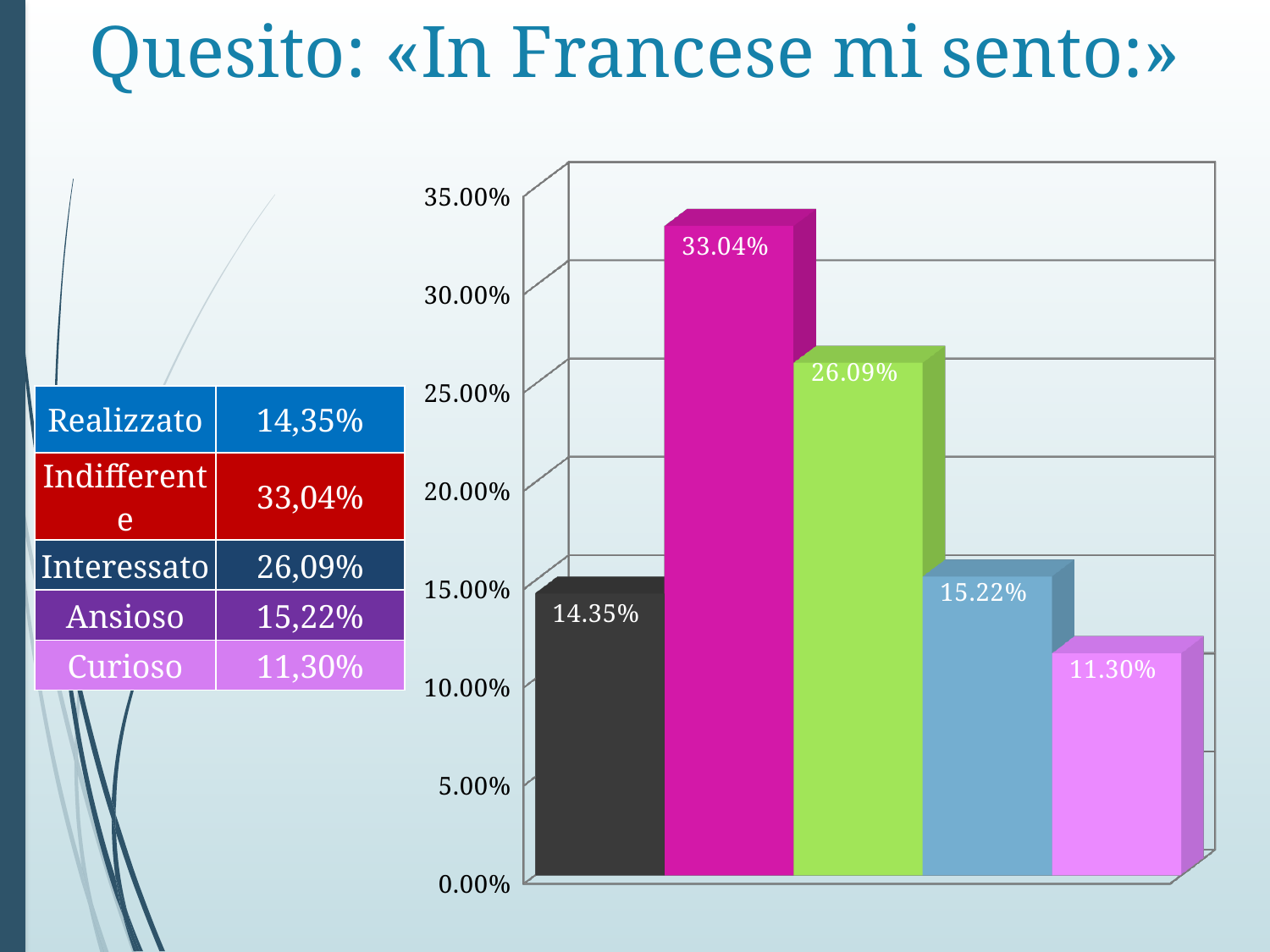
What kind of chart is shown on the slide? bar chart Is the value of the magenta bar greater or less than 30.00%? greater Which is larger, the first bar (14.35%) or the fourth bar (15.22%)? the fourth bar (15.22%) What is the data label on the fourth (light blue) bar? 15.22% How many bars are plotted in the chart? 5 What value is labelled on the tallest bar in the chart? 33.04% What is the data label on the third (green) bar? 26.09% According to the table on the slide, which category corresponds to the 33.04% bar? Indifferente What is the data label on the first (leftmost, dark grey) bar? 14.35% What is the difference between the second bar (33.04%) and the third bar (26.09%)? 6.95% What value is labelled on the shortest bar in the chart? 11.30% What is the highest value shown on the vertical axis of the chart? 35.00%